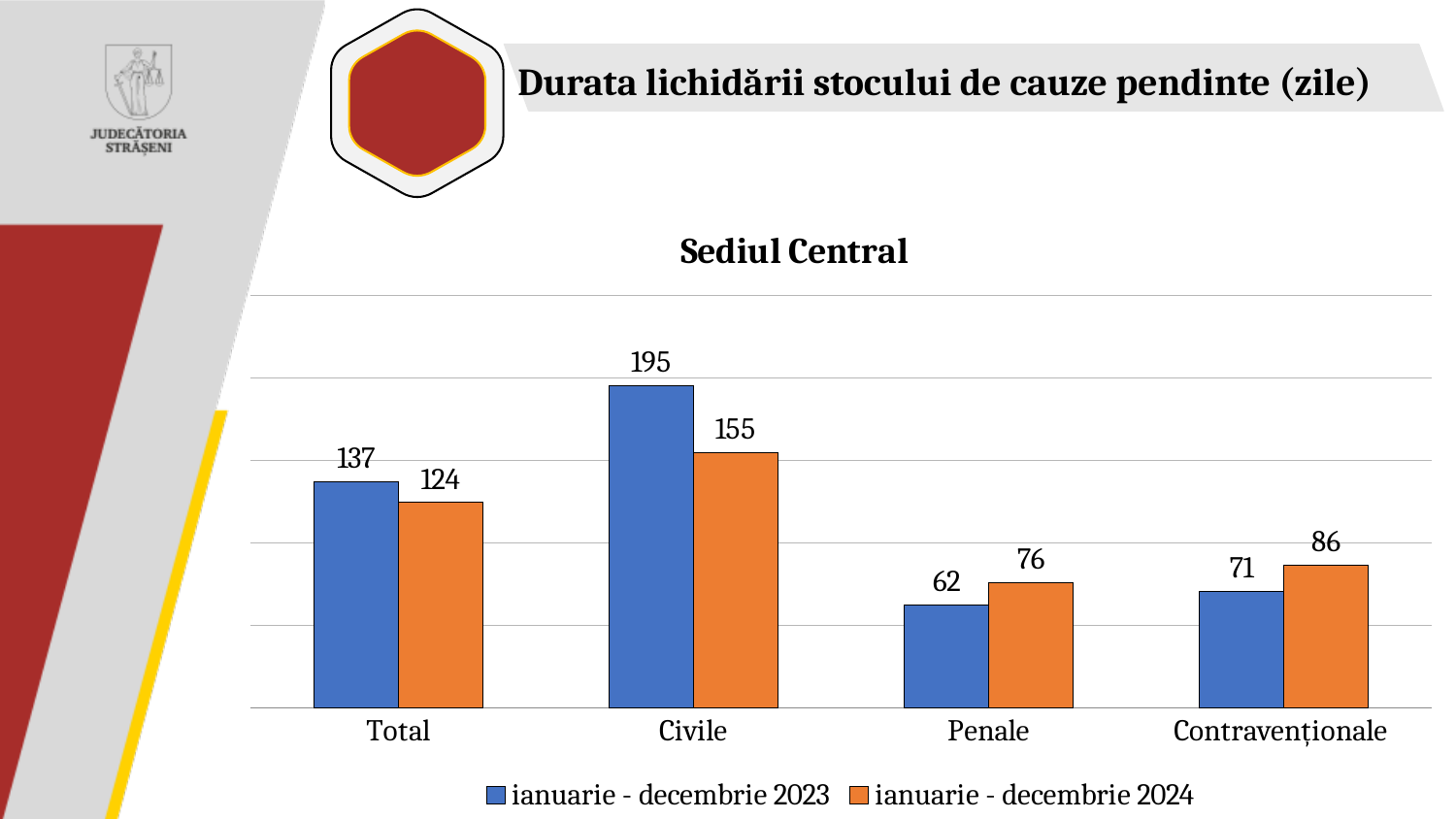
What is the value for Total in the ianuarie - decembrie 2024 series? 124 How many categories are shown on the x axis? 4 What is the title of the chart? Sediul Central How many series does the legend list? 2 Which category has the highest value in the ianuarie - decembrie 2023 series? Civile What is the value for Penale in the ianuarie - decembrie 2024 series? 76 Which is larger for Contravenționale: the ianuarie - decembrie 2023 value or the ianuarie - decembrie 2024 value? ianuarie - decembrie 2024 What is the value for Civile in the ianuarie - decembrie 2023 series? 195 What is the difference between the 2023 and 2024 values for Civile? 40 What kind of chart is shown? bar chart Which category has the lowest value in the ianuarie - decembrie 2024 series? Penale What colour are the bars for the ianuarie - decembrie 2024 series? orange